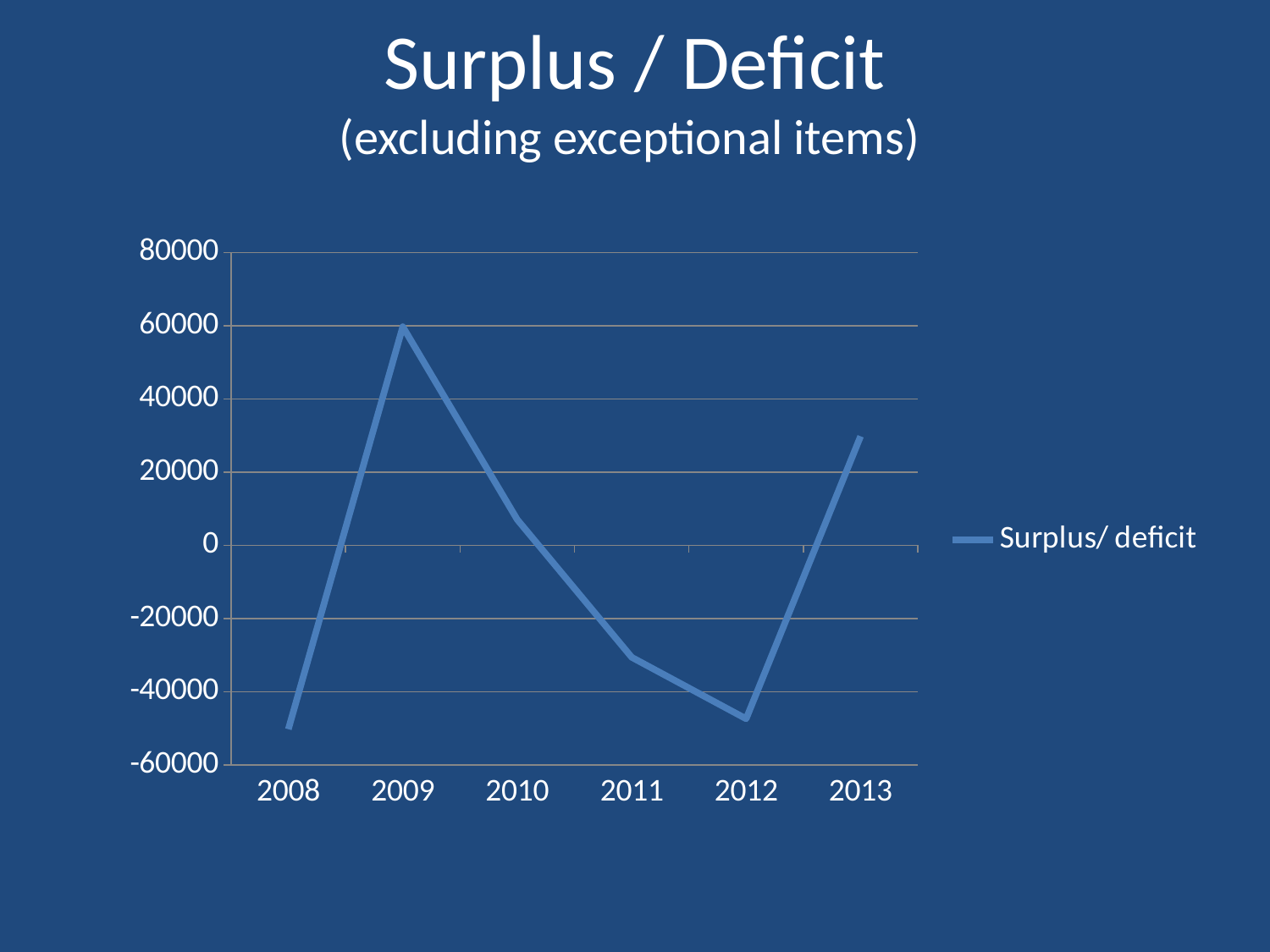
Is the value for 2013 greater or less than 20000? greater Which is larger, the value for 2011 or the value for 2012? 2011 What is the name of the series shown in the legend? Surplus/ deficit Which is larger, the value for 2009 or the value for 2013? 2009 Is the value for 2009 greater or less than 40000? greater How many years are plotted on the x axis? 6 What kind of chart is shown on the slide? line chart Which year has the highest surplus/deficit value? 2009 Is the value for 2011 greater or less than -20000? less How many series does the legend list? 1 Does the surplus/deficit value rise or fall from 2009 to 2012? fall